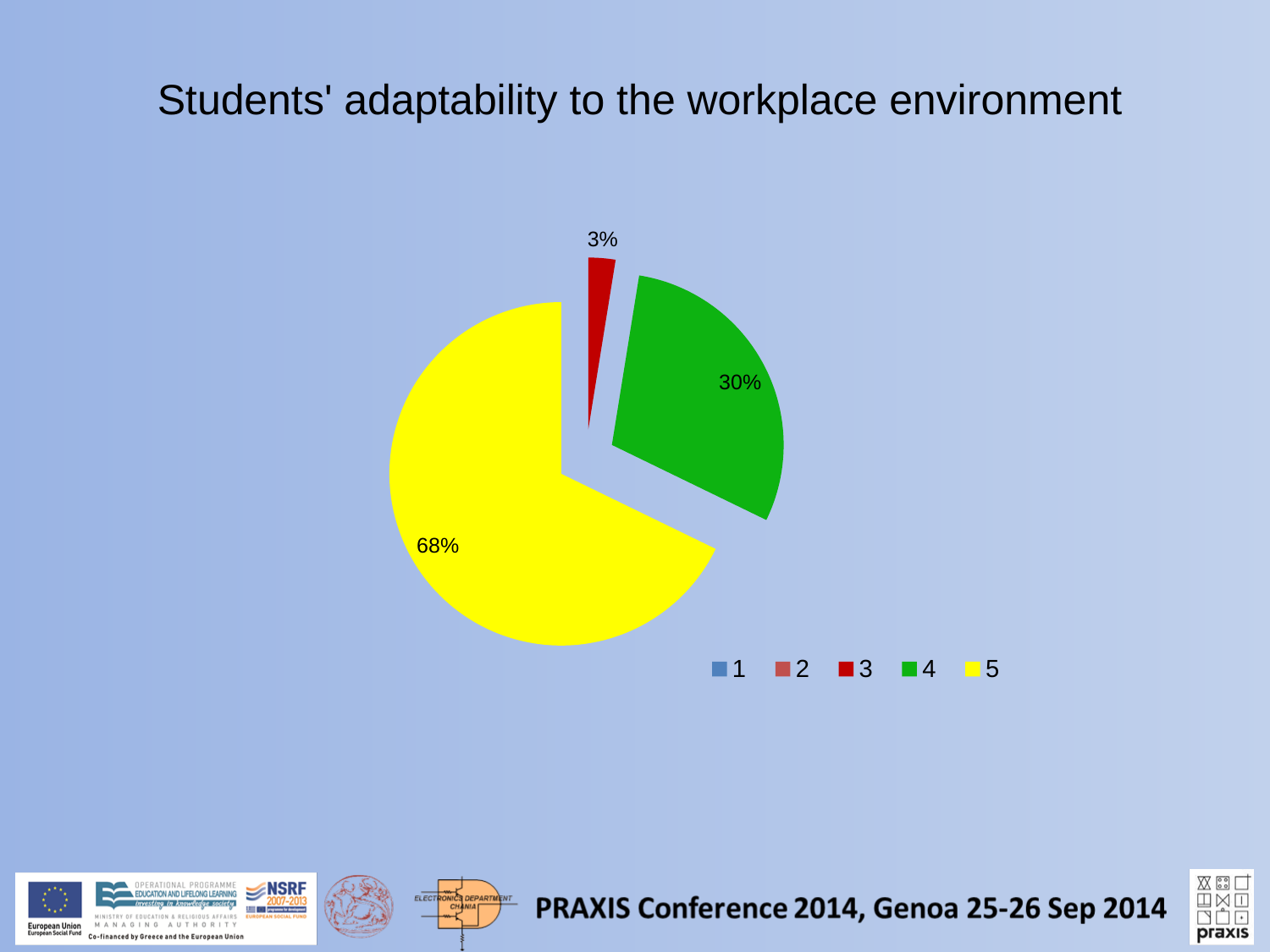
Which is larger, the share for category 4 or the share for category 3? 4 What kind of chart is shown on the slide? pie chart How many entries does the legend list? 5 What share of the pie does category 5 have? 68% What colour is the slice for category 5? yellow What share of the pie does category 4 have? 30% How many slices with a visible data label does the pie have? 3 What is the difference between the shares of category 5 and category 4? 38% Which category has the largest slice of the pie? 5 Which of the visible slices is the smallest? 3 What share of the pie does category 3 have? 3% What is the title of the chart? Students' adaptability to the workplace environment